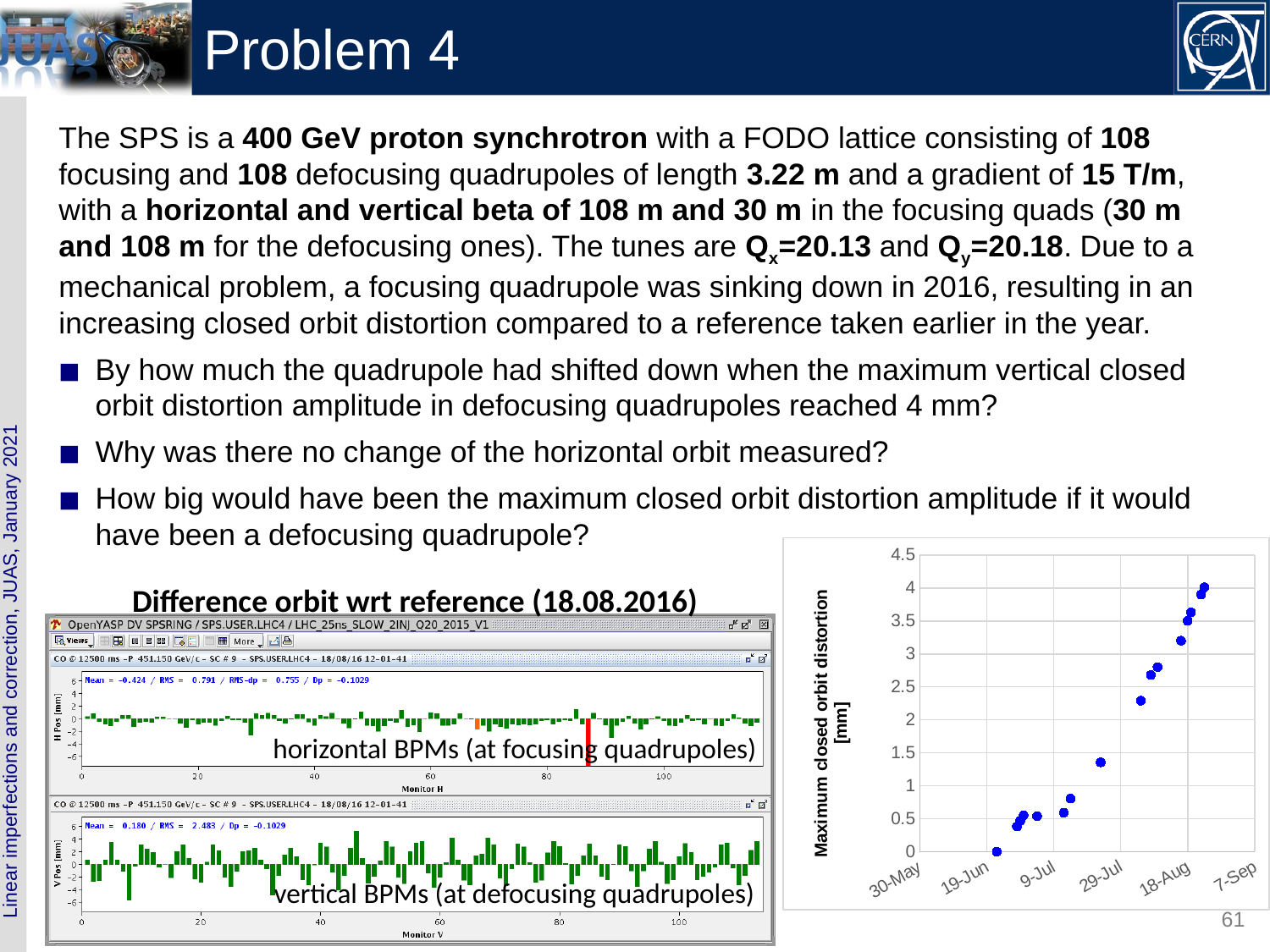
In the 'Difference orbit wrt reference (18.08.2016)' screenshot, which panel has the larger RMS: the horizontal BPMs or the vertical BPMs? vertical BPMs In the 'Difference orbit wrt reference (18.08.2016)' screenshot, what RMS value is printed for the vertical BPM panel? 2.483 What kind of chart is the chart on the right of the slide with the y-axis 'Maximum closed orbit distortion [mm]'? scatter chart In the scatter chart on the right, what is the first date label on the x axis? 30-May In the 'Difference orbit wrt reference (18.08.2016)' screenshot, what Mean value is printed for the horizontal BPM panel? -0.424 In the scatter chart on the right, is the highest plotted value greater or less than 3.5? greater In the scatter chart on the right, is the lowest plotted value greater or less than 0.5? less In the scatter chart on the right, which is larger: the value of the point near 29-Jul or the value of the point near 18-Aug? the point near 18-Aug In the scatter chart on the right, is the value of the point plotted near 29-Jul greater or less than 1? greater In the scatter chart on the right, what is the highest value shown on the y axis? 4.5 In the scatter chart on the right, do the values of maximum closed orbit distortion rise or fall as the date advances along the x axis? rise